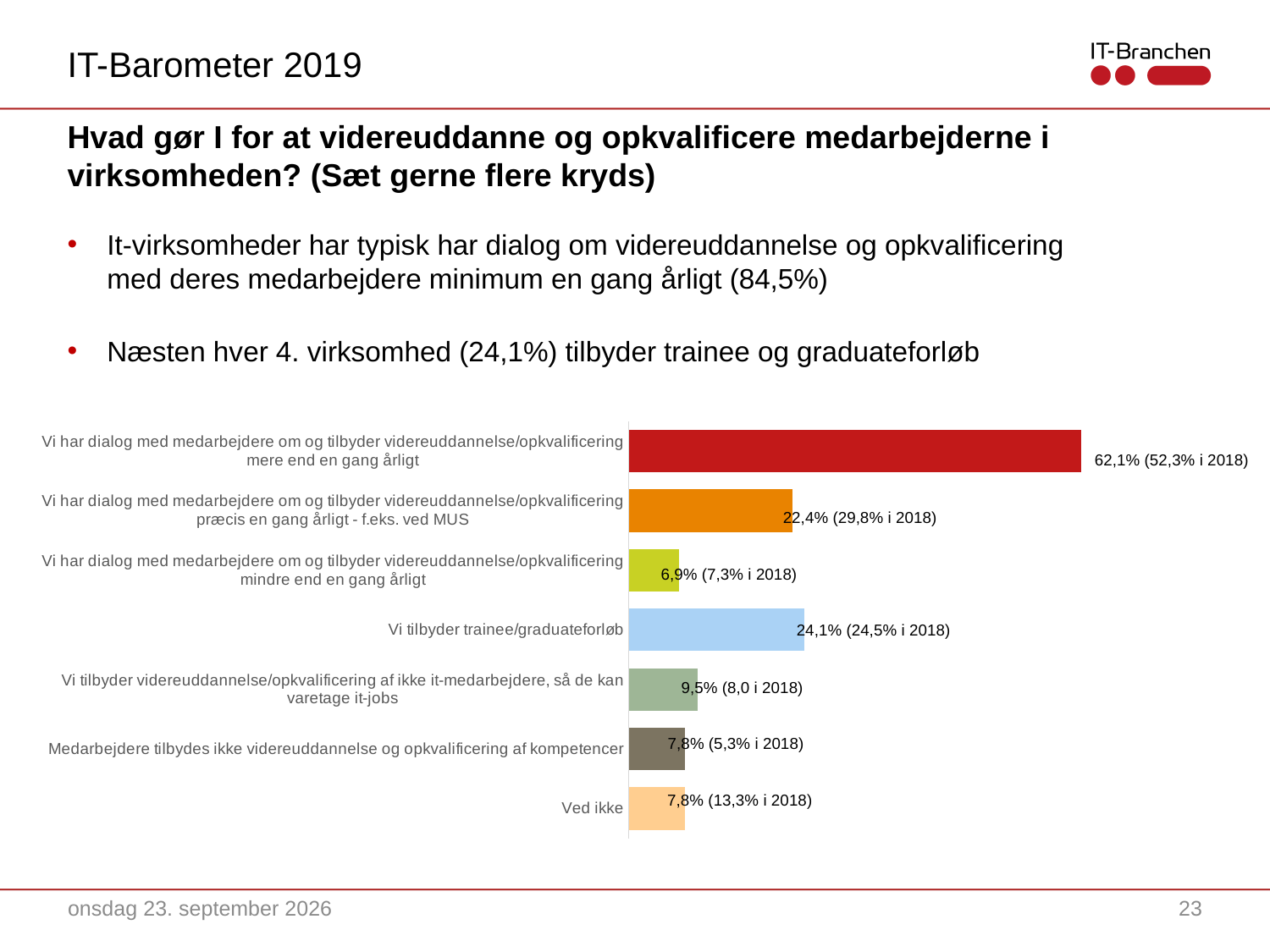
What kind of chart is shown on the slide? bar chart What is the difference in 2019 values between "mere end en gang årligt" (62,1%) and "præcis en gang årligt - f.eks. ved MUS" (22,4%)? 39,7 percentage points What colour is the bar for the category with the highest value? red Which category has the lowest 2019 value? Vi har dialog med medarbejdere om og tilbyder videreuddannelse/opkvalificering mindre end en gang årligt What was the 2018 value shown for "Vi tilbyder trainee/graduateforløb"? 24,5% What is the 2019 value for "Vi tilbyder trainee/graduateforløb"? 24,1% Which category has the highest 2019 value? Vi har dialog med medarbejdere om og tilbyder videreuddannelse/opkvalificering mere end en gang årligt What is the 2019 value for "Medarbejdere tilbydes ikke videreuddannelse og opkvalificering af kompetencer"? 7,8% How many categories does the chart show? 7 What is the 2019 value for "Vi har dialog med medarbejdere om og tilbyder videreuddannelse/opkvalificering mere end en gang årligt"? 62,1% What was the 2018 value shown for "Ved ikke"? 13,3% Which has the larger 2019 value: "Vi tilbyder trainee/graduateforløb" or "Vi har dialog med medarbejdere om og tilbyder videreuddannelse/opkvalificering præcis en gang årligt - f.eks. ved MUS"? Vi tilbyder trainee/graduateforløb